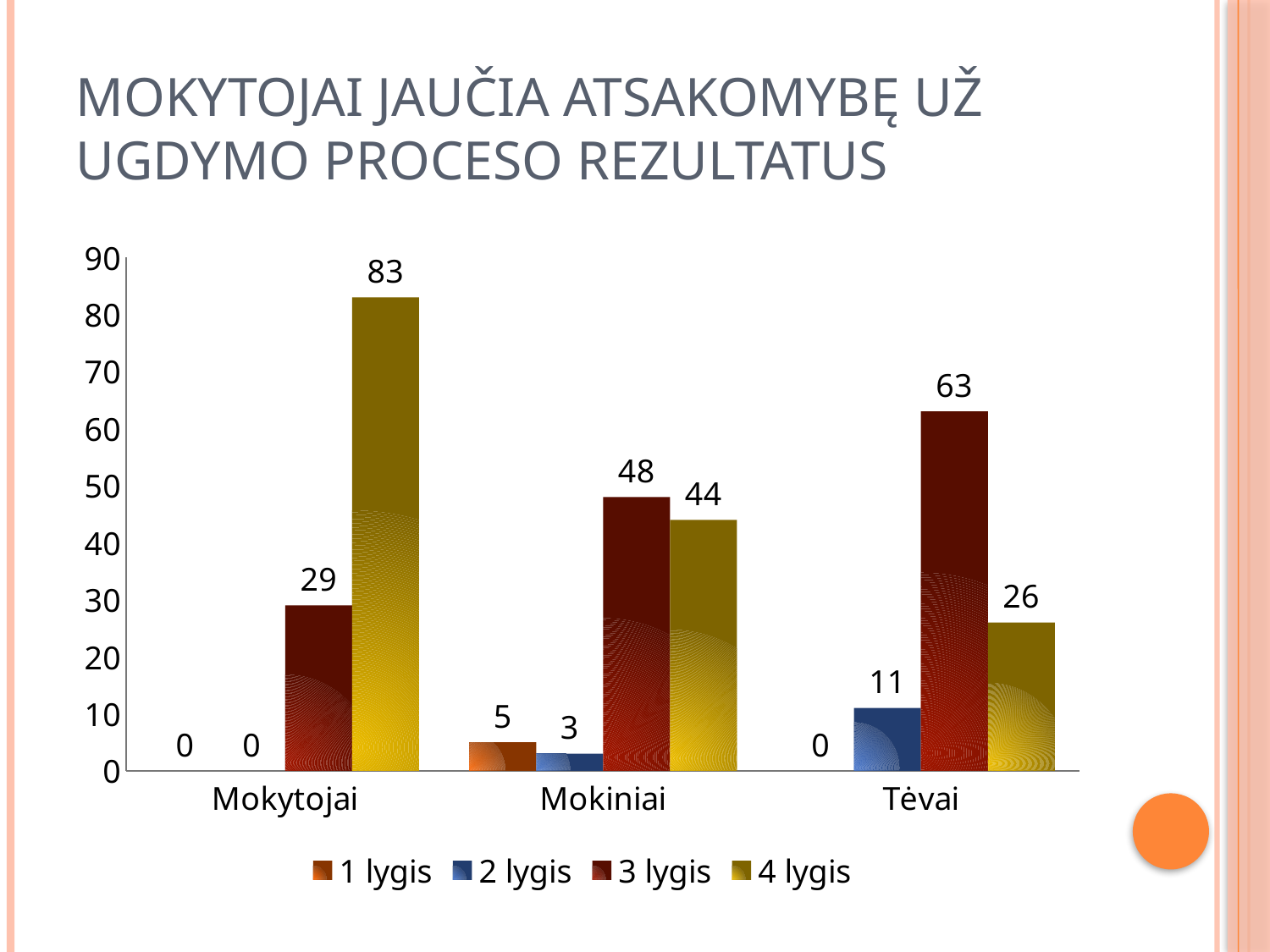
What is the value for 3 lygis in the Tėvai category? 63 What kind of chart is shown on the slide? Bar chart What is the value for 2 lygis in the Mokiniai category? 3 What is the value for 4 lygis in the Mokytojai category? 83 Which category has the highest value for 4 lygis? Mokytojai What is the value for 1 lygis in the Tėvai category? 0 Which is larger in the Tėvai category: 3 lygis or 4 lygis? 3 lygis How many categories are shown on the x axis? 3 What is the difference between the 3 lygis and 4 lygis values in the Mokiniai category? 4 What is the value for 2 lygis in the Tėvai category? 11 How many series does the legend list? 4 Which category has the lowest value for 3 lygis? Mokytojai